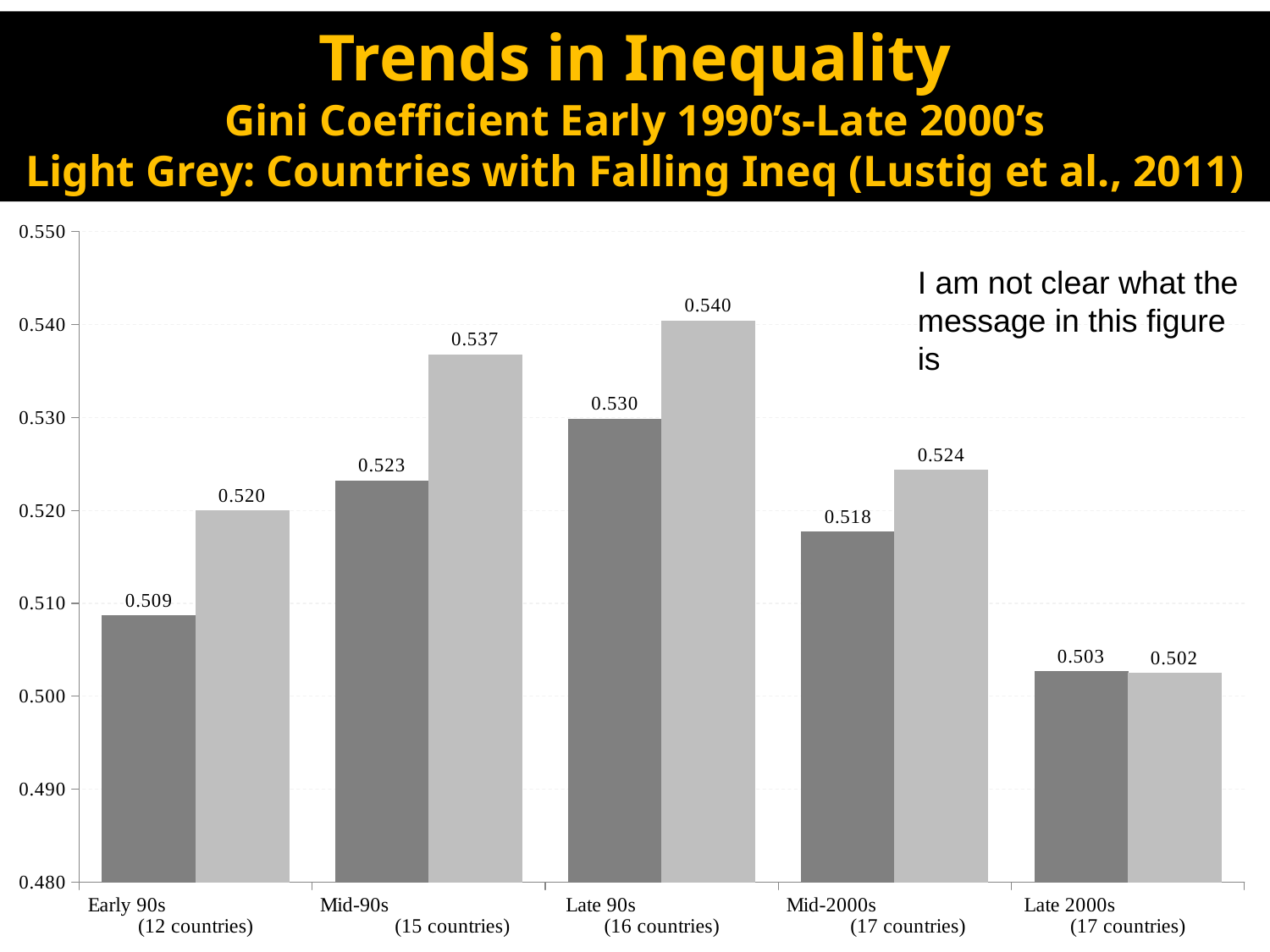
What is the value of the light grey bar for Late 90s? 0.540 Which period has the lowest dark grey bar? Late 2000s Which period has the highest light grey bar? Late 90s Which is larger for Early 90s, the dark grey bar or the light grey bar? the light grey bar How many time periods are shown on the x axis? 5 What kind of chart is shown on the slide? bar chart What is the value of the light grey bar for Mid-90s? 0.537 Is the dark grey value for Late 90s greater or less than 0.520? greater What is the difference between the light grey and dark grey bars for Mid-90s? 0.014 What is the value of the dark grey bar for Mid-2000s? 0.518 What is the value of the dark grey bar for Early 90s? 0.509 According to the slide title, what do the light grey bars represent? Countries with Falling Ineq